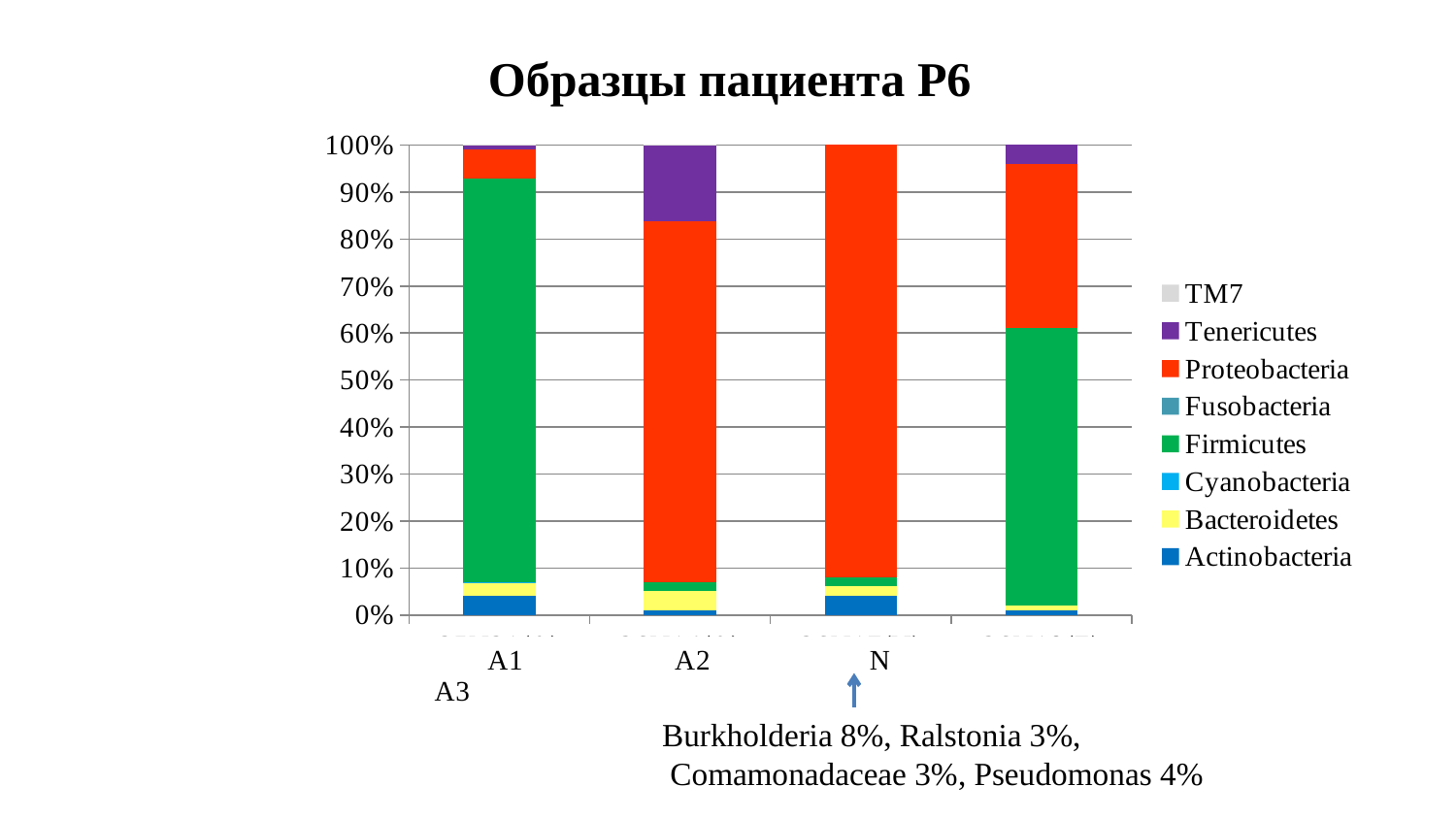
Is the Proteobacteria segment in bar N greater or less than 80%? greater Which bar has a larger Firmicutes segment, A1 or A2? A1 According to the annotation below the chart, what percentage is given for Burkholderia? 8% Which bar has the largest Firmicutes segment? A1 What is the title of the chart? Образцы пациента P6 How many series does the legend list? 8 Which bar has the largest Proteobacteria segment? N How many stacked bars are plotted in the chart? 4 Which bar has the largest Tenericutes segment? A2 Is the Firmicutes segment in bar A1 greater or less than 80%? greater Is the Tenericutes segment in bar A2 greater or less than 20%? less What kind of chart is shown on the slide? Stacked bar chart